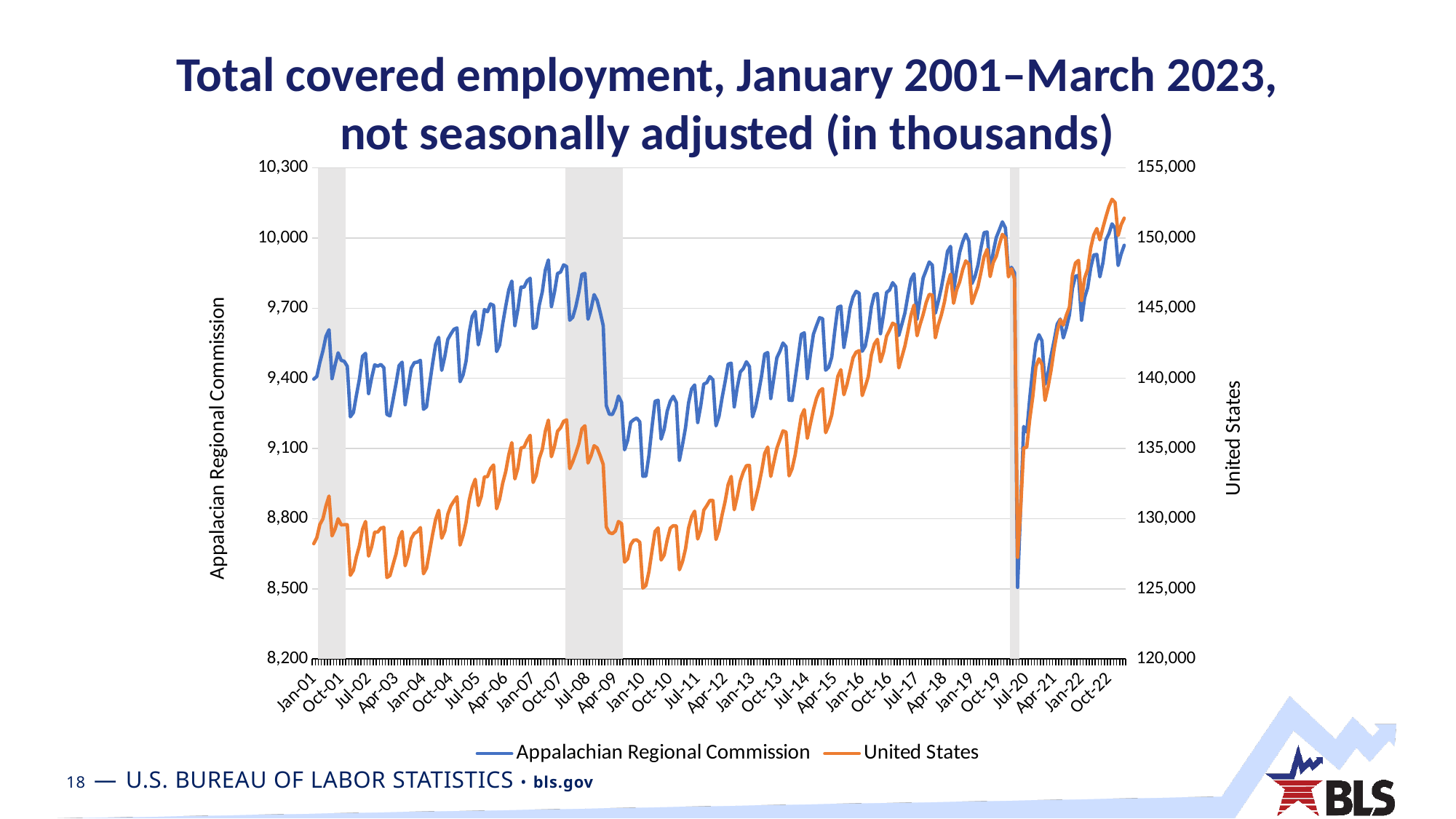
How many series does the legend list? 2 Is the Appalachian Regional Commission value at its peak near Oct-19 greater or less than 9,700? greater What is the label of the right-hand vertical axis? United States Is the United States value at its peak near Oct-22 greater or less than 150,000? greater What kind of chart is shown on the slide? line chart Is the United States value at its sharp dip near Jul-20 greater or less than 130,000? less Which series is plotted in orange? United States Overall, does the United States series rise or fall from Jan-01 to the end of the chart? rise Does the Appalachian Regional Commission series rise or fall across the shaded region from Jul-08 to Apr-09? fall